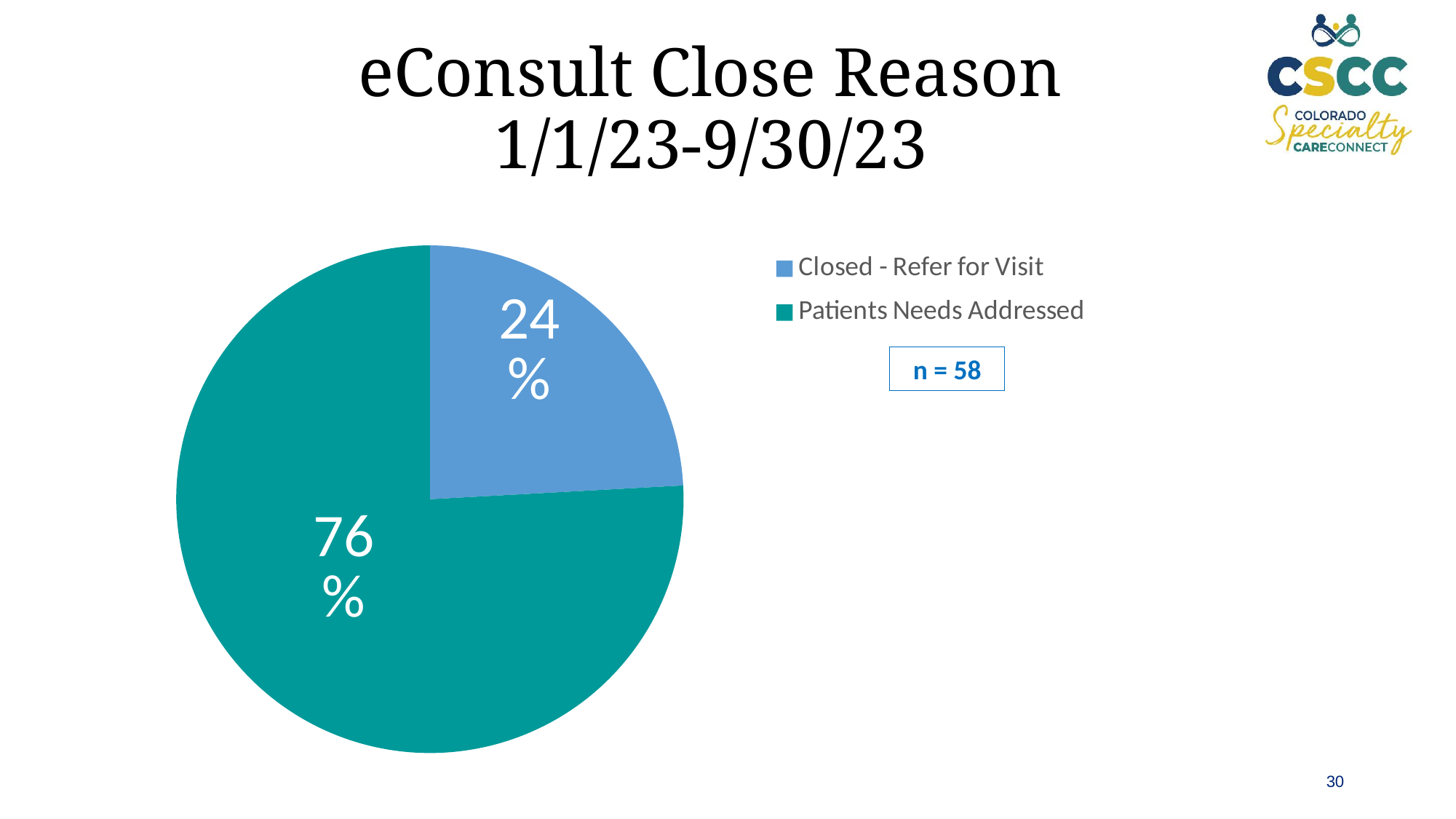
How many slices does the pie chart have? 2 What is the difference in percentage points between the "Patients Needs Addressed" and "Closed - Refer for Visit" slices? 52 percentage points What colour is the "Closed - Refer for Visit" slice? blue What share of the pie is labelled "Patients Needs Addressed"? 76% What is the sample size (n) shown next to the chart? n = 58 How many entries does the legend list? 2 Which close reason has the smallest share of the pie? Closed - Refer for Visit What share of the pie is labelled "Closed - Refer for Visit"? 24% Which close reason has the largest share of the pie? Patients Needs Addressed What kind of chart is shown on the slide? pie chart Which is larger: the "Closed - Refer for Visit" slice or the "Patients Needs Addressed" slice? Patients Needs Addressed